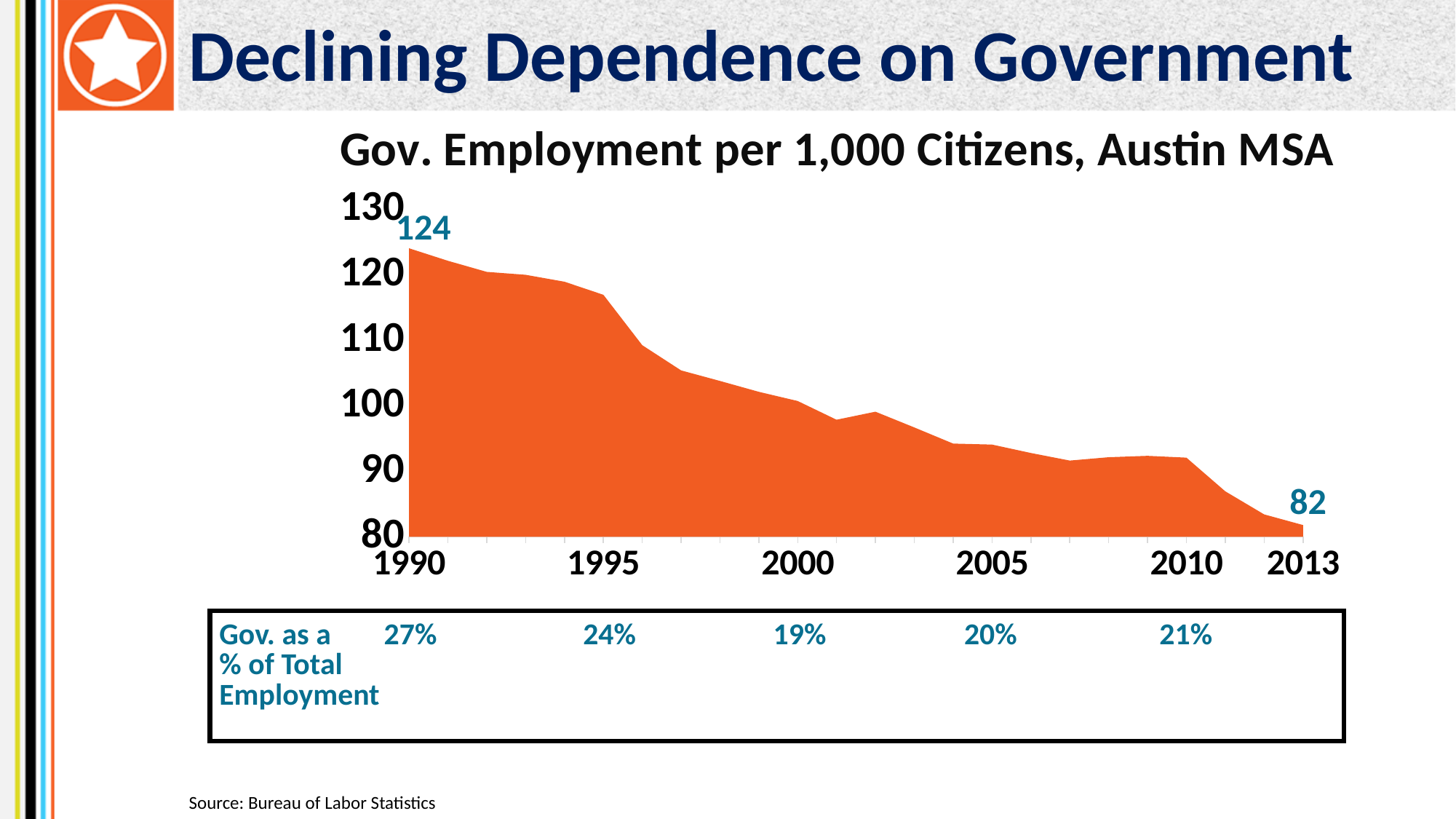
What is the title of the chart? Gov. Employment per 1,000 Citizens, Austin MSA Is the value for 1995 greater or less than 110? greater Which year has the highest Gov. Employment per 1,000 Citizens? 1990 Do the values in the Gov. Employment per 1,000 Citizens chart rise or fall from 1990 to 2013? fall Which is larger, the value for 1990 or the value for 2013? 1990 Is the value for 2005 greater or less than 100? less Which year has the lowest Gov. Employment per 1,000 Citizens? 2013 According to the box below the chart, what was Gov. as a % of Total Employment in 1990? 27% By how much did Gov. Employment per 1,000 Citizens fall from 1990 to 2013? 42 What is the value for 2013 in the Gov. Employment per 1,000 Citizens chart? 82 What kind of chart is used to show Gov. Employment per 1,000 Citizens? area chart What is the value for 1990 in the Gov. Employment per 1,000 Citizens chart? 124